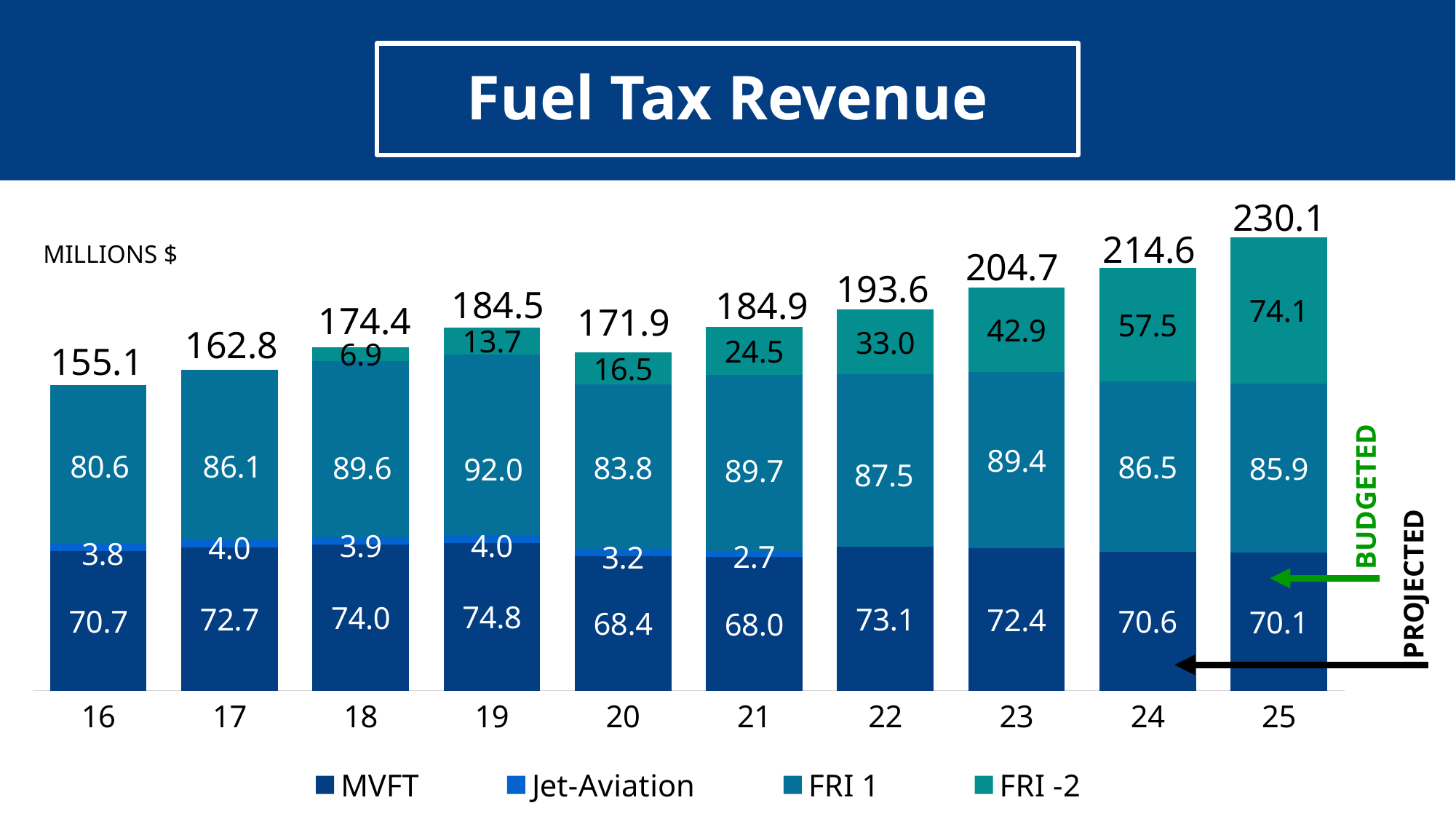
What is the MVFT value for year 19? 74.8 What type of chart is shown on the slide? Stacked bar chart Which year has the highest total fuel tax revenue? 25 Which year has the lowest total fuel tax revenue? 16 Does the FRI -2 value rise or fall from year 18 to year 25? Rise How many years are shown along the x axis? 10 What is the total fuel tax revenue for year 25? 230.1 Which is larger, the FRI 1 value for year 19 or for year 20? Year 19 What is the Jet-Aviation value for year 21? 2.7 How many series does the legend list? 4 What is the FRI -2 value for year 23? 42.9 What is the difference between the total revenue for year 25 and year 24? 15.5